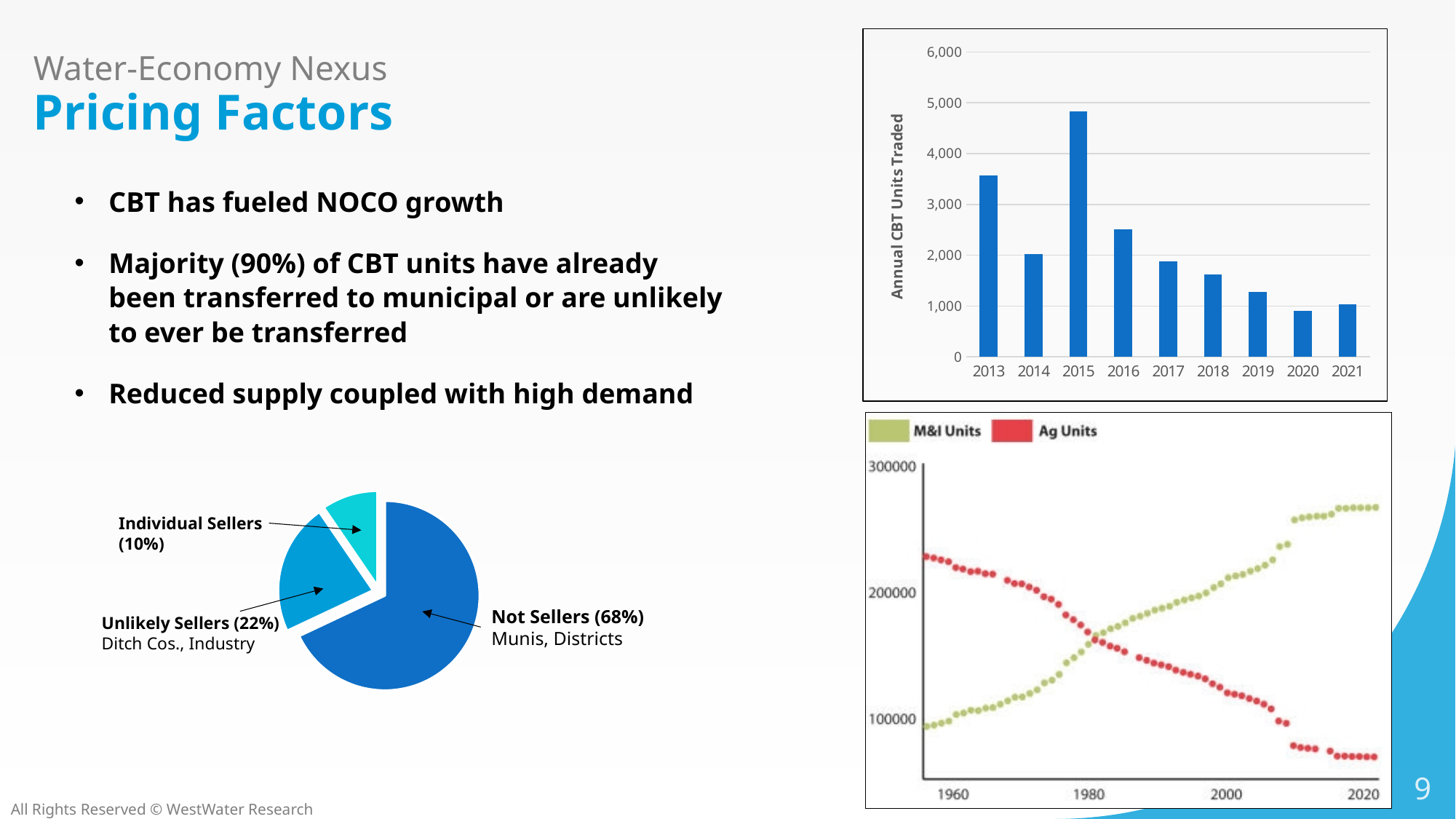
In the pie chart at the bottom left, what share is Not Sellers? 68% In the top-right bar chart of Annual CBT Units Traded, which is larger, the value for 2016 or the value for 2019? 2016 How many years are shown in the top-right bar chart of Annual CBT Units Traded? 9 In the top-right bar chart of Annual CBT Units Traded, which year has the lowest value? 2020 In the top-right bar chart of Annual CBT Units Traded, is the value for 2020 greater or less than 1,000? less In the pie chart at the bottom left, what share is Unlikely Sellers? 22% In the bottom-right chart, do the Ag Units values rise or fall from 1960 to 2020? fall In the top-right bar chart of Annual CBT Units Traded, is the value for 2015 greater or less than 4,000? greater In the top-right bar chart of Annual CBT Units Traded, is the value for 2013 greater or less than 3,000? greater In the top-right bar chart of Annual CBT Units Traded, which year has the highest value? 2015 How many series does the legend of the bottom-right chart list? 2 In the pie chart at the bottom left, what is the difference in percentage points between Not Sellers and Individual Sellers? 58